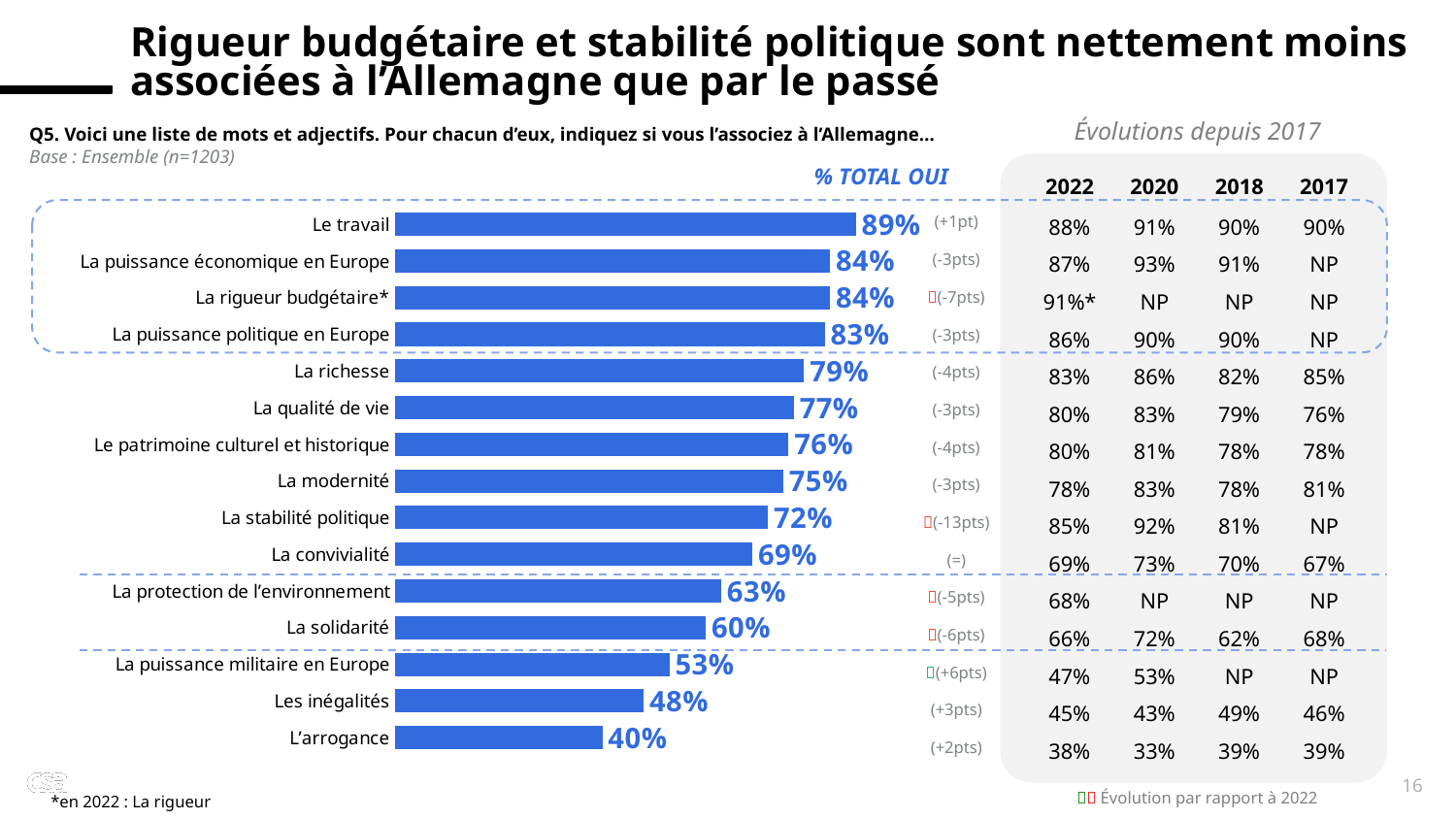
What is the value for "Le travail" in the bar chart? 89% What is the value for "La convivialité" in the bar chart? 69% Which category has the lowest value in the bar chart? L'arrogance What label appears above the bar values in the chart? % TOTAL OUI What is the difference between the values for "Le travail" and "L'arrogance"? 49 points Which has a larger value, "La richesse" or "La modernité"? La richesse How many categories are shown in the bar chart? 15 What is the value for "La stabilité politique" in the bar chart? 72% What kind of chart is shown on the slide? Bar chart What is the value for "La puissance militaire en Europe" in the bar chart? 53% Which category has the highest value in the bar chart? Le travail What is the difference between the values for "La solidarité" and "Les inégalités"? 12 points